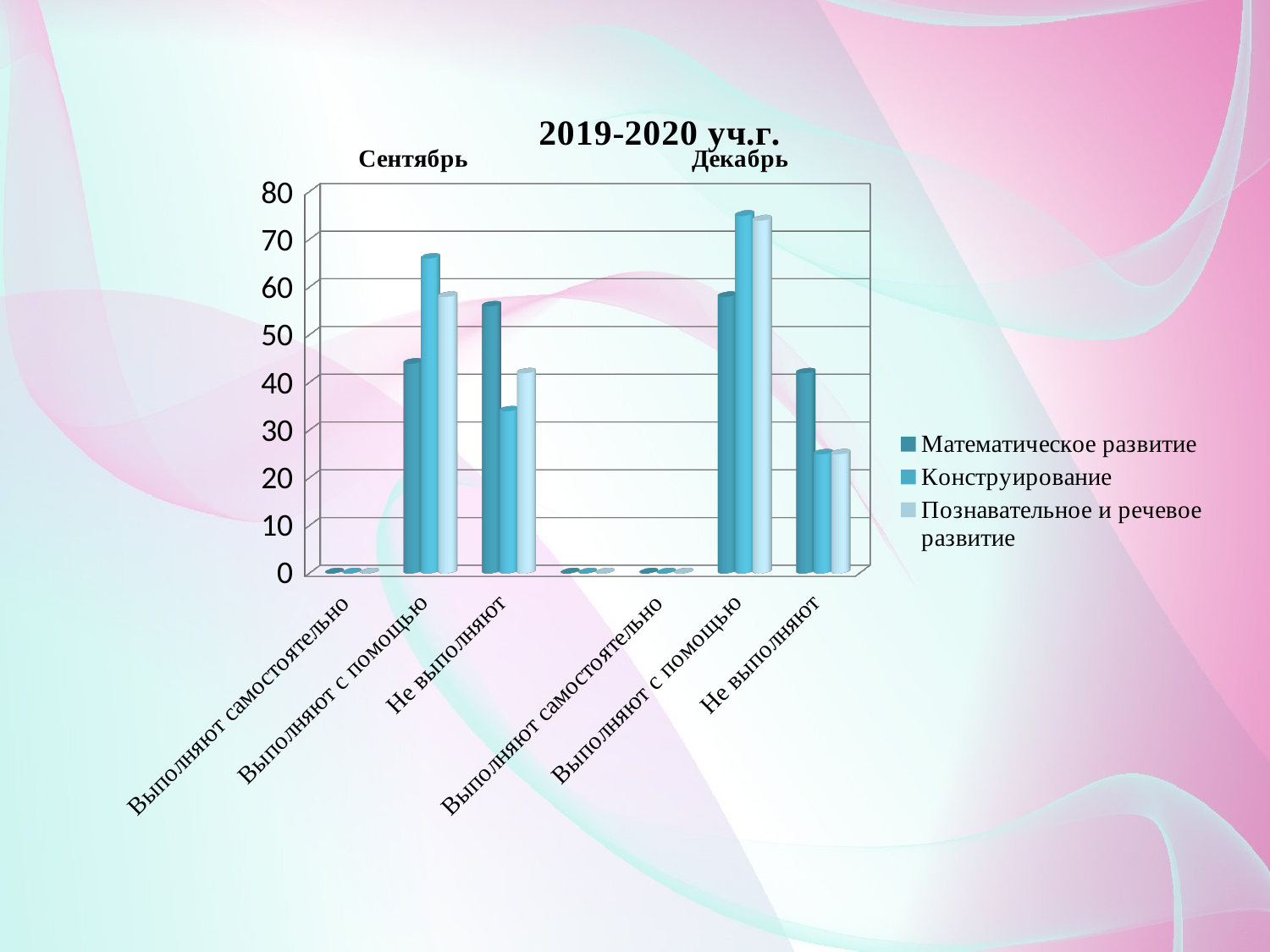
Is the value for Конструирование in the December 'Не выполняют' category greater or less than 30? less Which series is listed last in the legend? Познавательное и речевое развитие What kind of chart is shown on the slide? bar chart In the September 'Не выполняют' category, which is larger: Математическое развитие or Конструирование? Математическое развитие Is the value for Конструирование in the September 'Выполняют с помощью' category greater or less than 60? greater How many series does the legend list? 3 What is the title of the chart? 2019-2020 уч.г. How many categories are shown along the x axis? 6 Is the value for Конструирование in the December 'Выполняют с помощью' category greater or less than 70? greater In the September 'Выполняют с помощью' category, which series has the highest value? Конструирование What is the value for Математическое развитие in the September 'Выполняют самостоятельно' category? 0 In the December 'Не выполняют' category, which series has the highest value? Математическое развитие